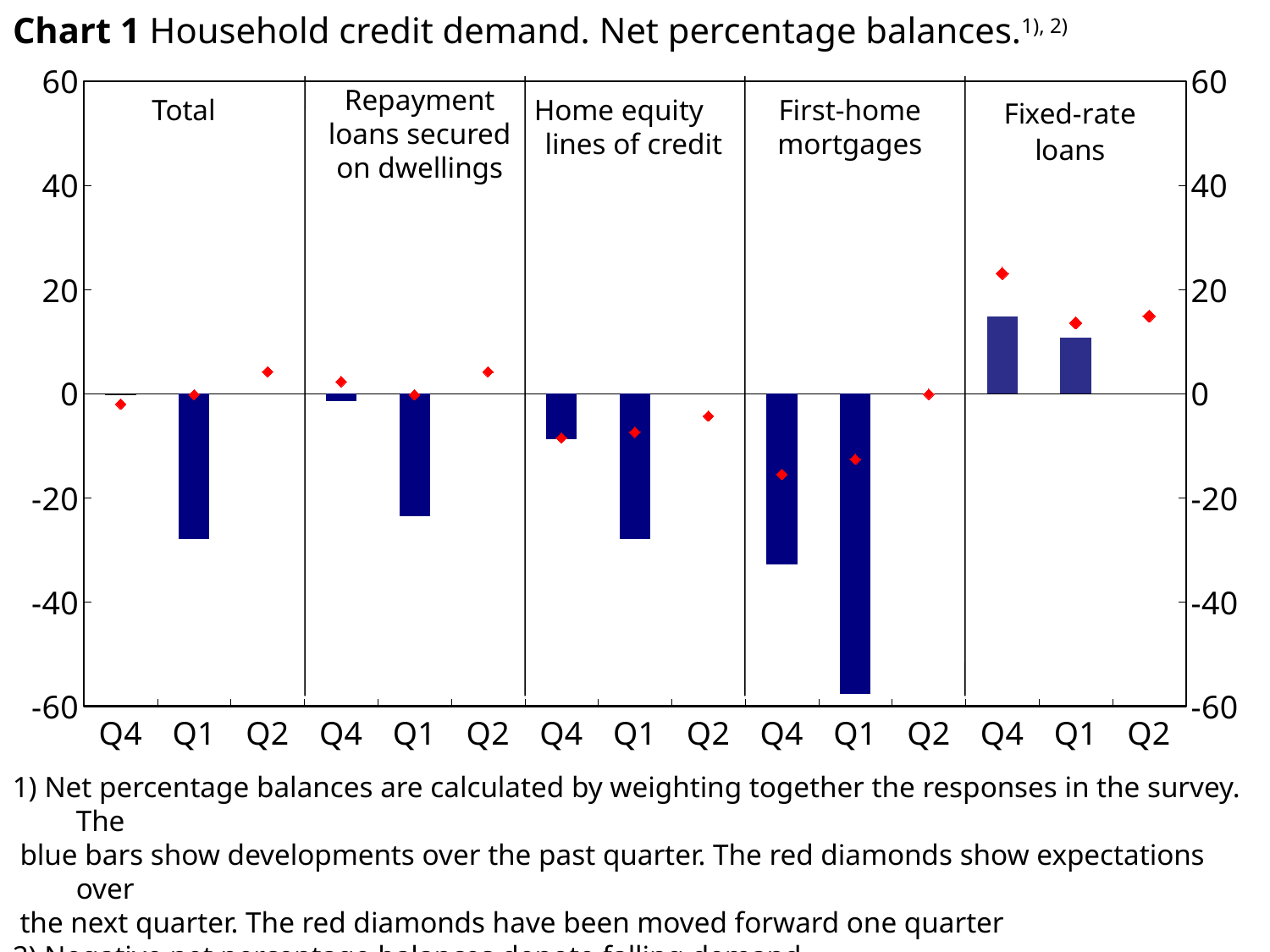
Is the Q4 bar for Fixed-rate loans greater or less than 10? greater Which credit category is the only one with positive blue bars in Chart 1? Fixed-rate loans How many credit categories (panels) are shown in Chart 1? 5 Which is lower, the Q1 bar for Total or the Q1 bar for Repayment loans secured on dwellings? Total What kind of chart is Chart 1? bar chart Which credit category has the lowest bar in Chart 1? First-home mortgages According to the footnote, what do the red diamonds in Chart 1 show? Expectations over the next quarter Is the Q1 bar for First-home mortgages greater or less than -40? less Do the blue bars for Fixed-rate loans rise or fall from Q4 to Q1? fall For Fixed-rate loans, which bar is larger, Q4 or Q1? Q4 Is the Q4 bar for First-home mortgages greater or less than -20? less